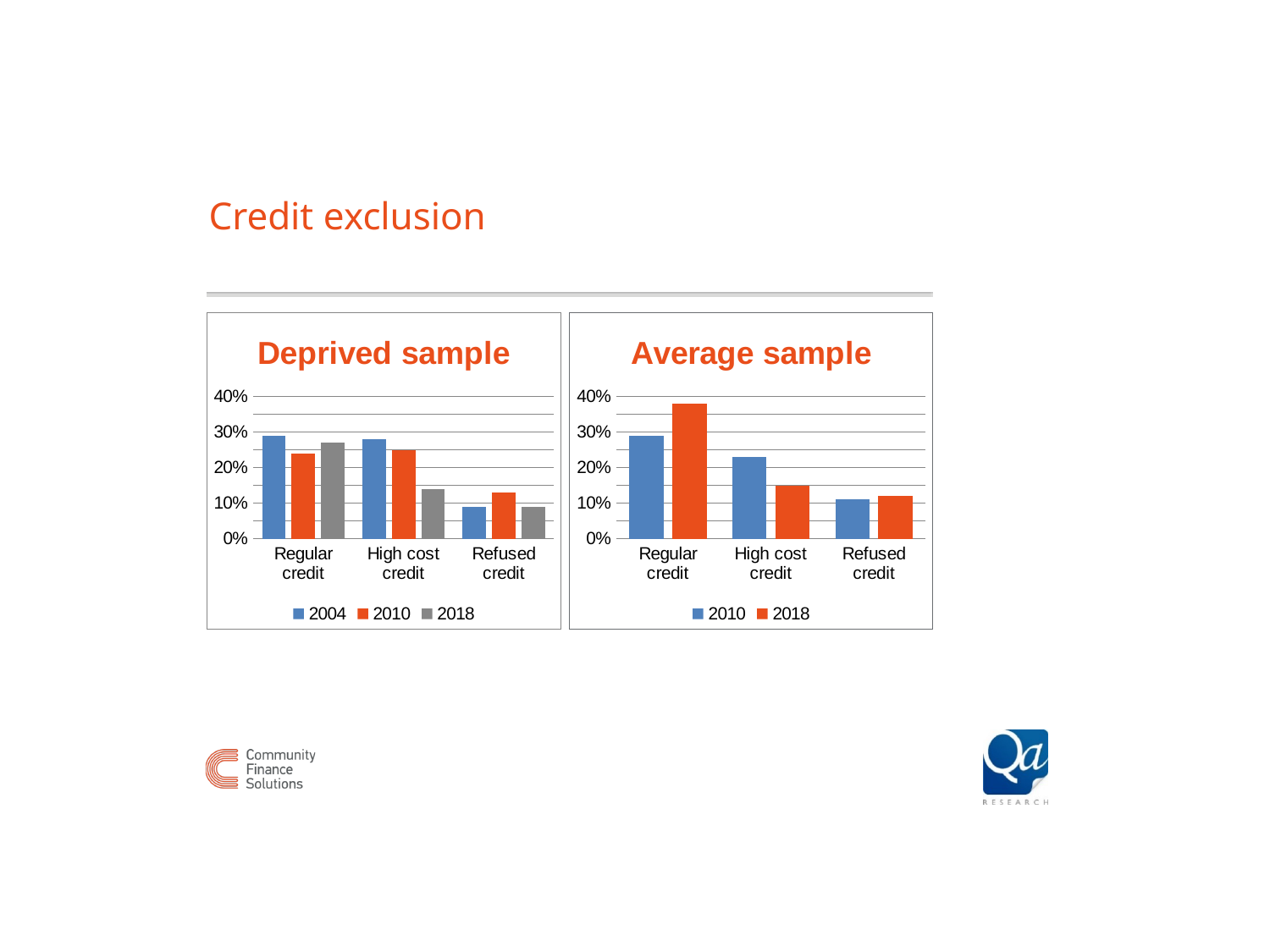
In the Deprived sample chart, how many series does the legend list? 3 In the Average sample chart, which category has the highest 2018 value? Regular credit In the Average sample chart, is the 2018 value for High cost credit greater or less than 20%? less What kind of chart is the Average sample chart? Bar chart In the Average sample chart, is the 2018 value for Regular credit greater or less than 30%? greater Which series is shown in orange in the Deprived sample chart? 2010 In the Deprived sample chart, how many categories are shown on the x axis? 3 In the Deprived sample chart, which category has the lowest 2004 value? Refused credit In the Average sample chart, how many series does the legend list? 2 In the Average sample chart, which is larger for High cost credit, the 2010 value or the 2018 value? 2010 In the Deprived sample chart, is the 2004 value for Regular credit greater or less than 20%? greater